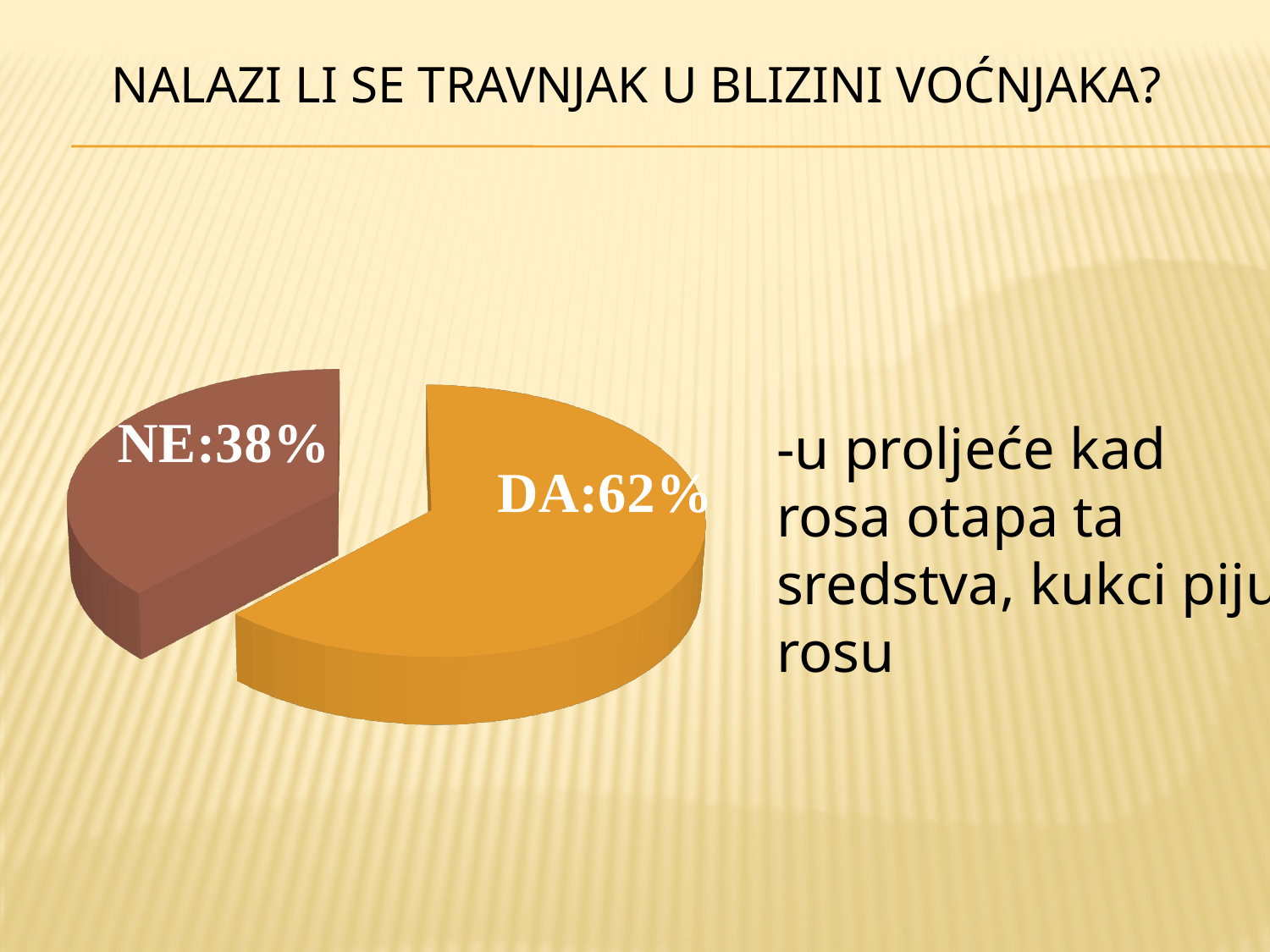
Which slice of the pie chart is the smallest? NE What share of the pie does the NE slice represent? 38% What colour is the DA slice of the pie chart? orange How many slices does the pie chart have? 2 What is the title of the slide containing the pie chart? NALAZI LI SE TRAVNJAK U BLIZINI VOĆNJAKA? What is the difference between the DA and NE values? 24% What kind of chart is shown on the slide? pie chart Which is larger, DA or NE? DA What is the value for DA in the pie chart? 62% What is the value for NE in the pie chart? 38% Which slice of the pie chart is the largest? DA